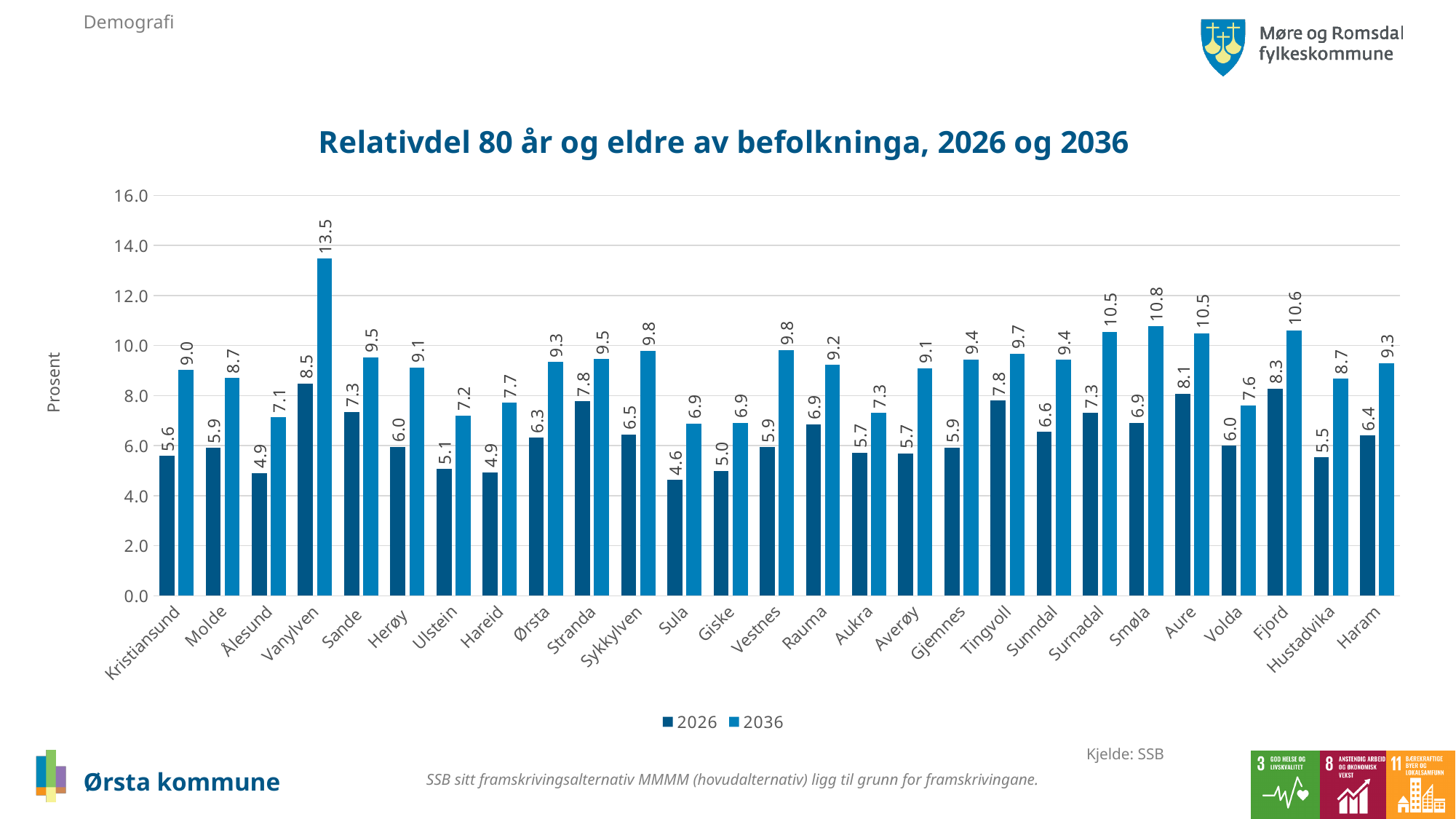
Is the 2036 value for Vanylven greater or less than 12.0? greater Which municipality has the lowest value in the 2026 series? Sula What is the value for Ørsta in the 2036 series? 9.3 Which municipality has the highest value in the 2036 series? Vanylven How many series does the legend list? 2 What kind of chart is shown on the slide? Bar chart What is the difference between the 2036 and 2026 values for Ørsta? 3.0 Which is larger: the 2026 value for Fjord or the 2026 value for Volda? Fjord What is the value for Smøla in the 2036 series? 10.8 What is the difference between the 2036 and 2026 values for Vanylven? 5.0 How many municipalities are shown on the x axis? 27 What is the value for Vanylven in the 2026 series? 8.5